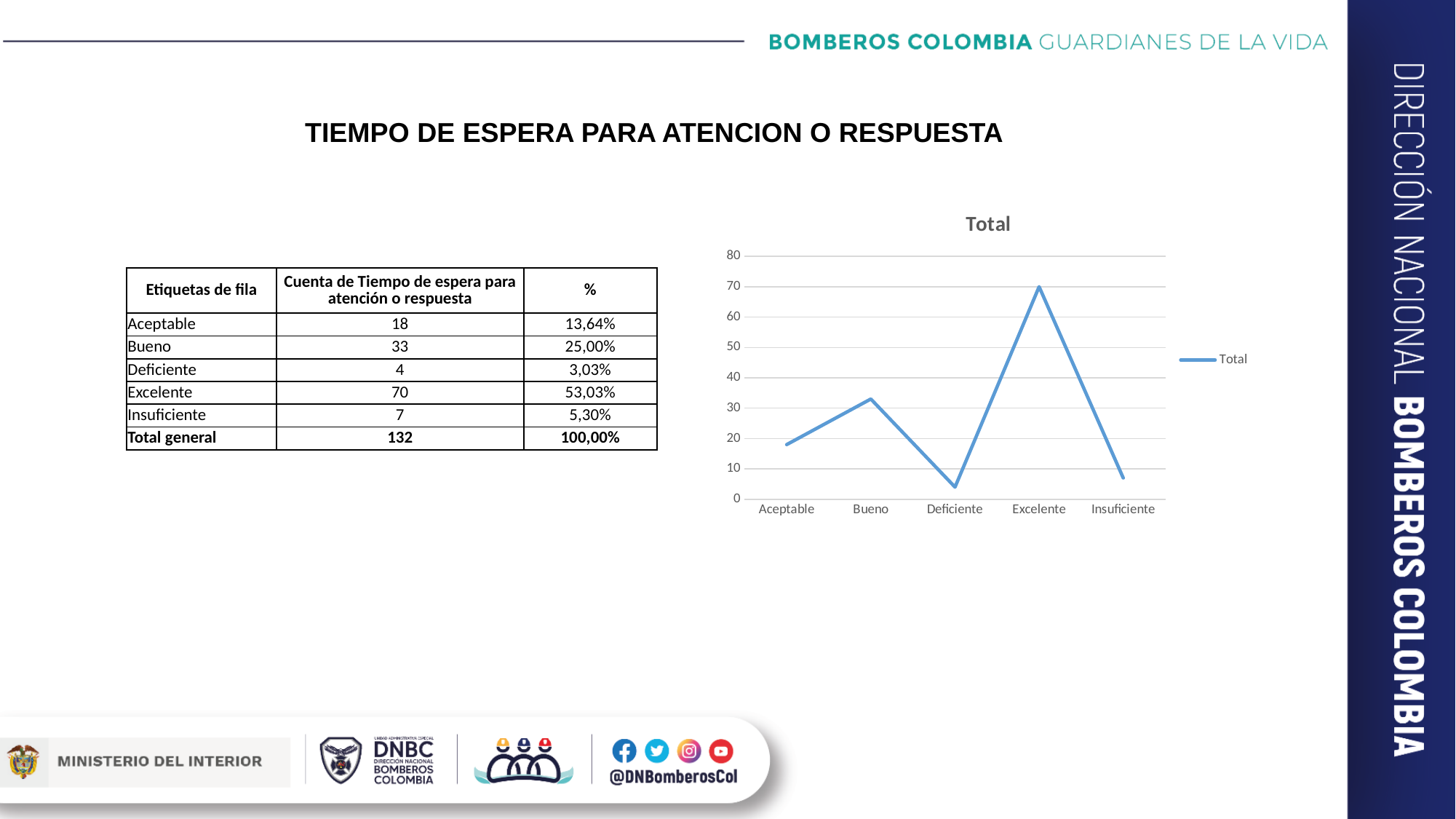
What kind of chart is shown on the slide? line chart How many categories are plotted along the x axis of the chart? 5 How many series does the chart legend list? 1 Which category has the lowest value in the chart? Deficiente Which category has the highest value in the chart? Excelente What is the difference between the values for Excelente and Bueno? 37 What is the title of the chart? Total Is the value for Aceptable greater or less than 20? less What is the value for Bueno in the chart? 33 Is the value for Insuficiente greater or less than 10? less Which is larger, the value for Bueno or the value for Aceptable? Bueno What is the value for Excelente in the chart? 70